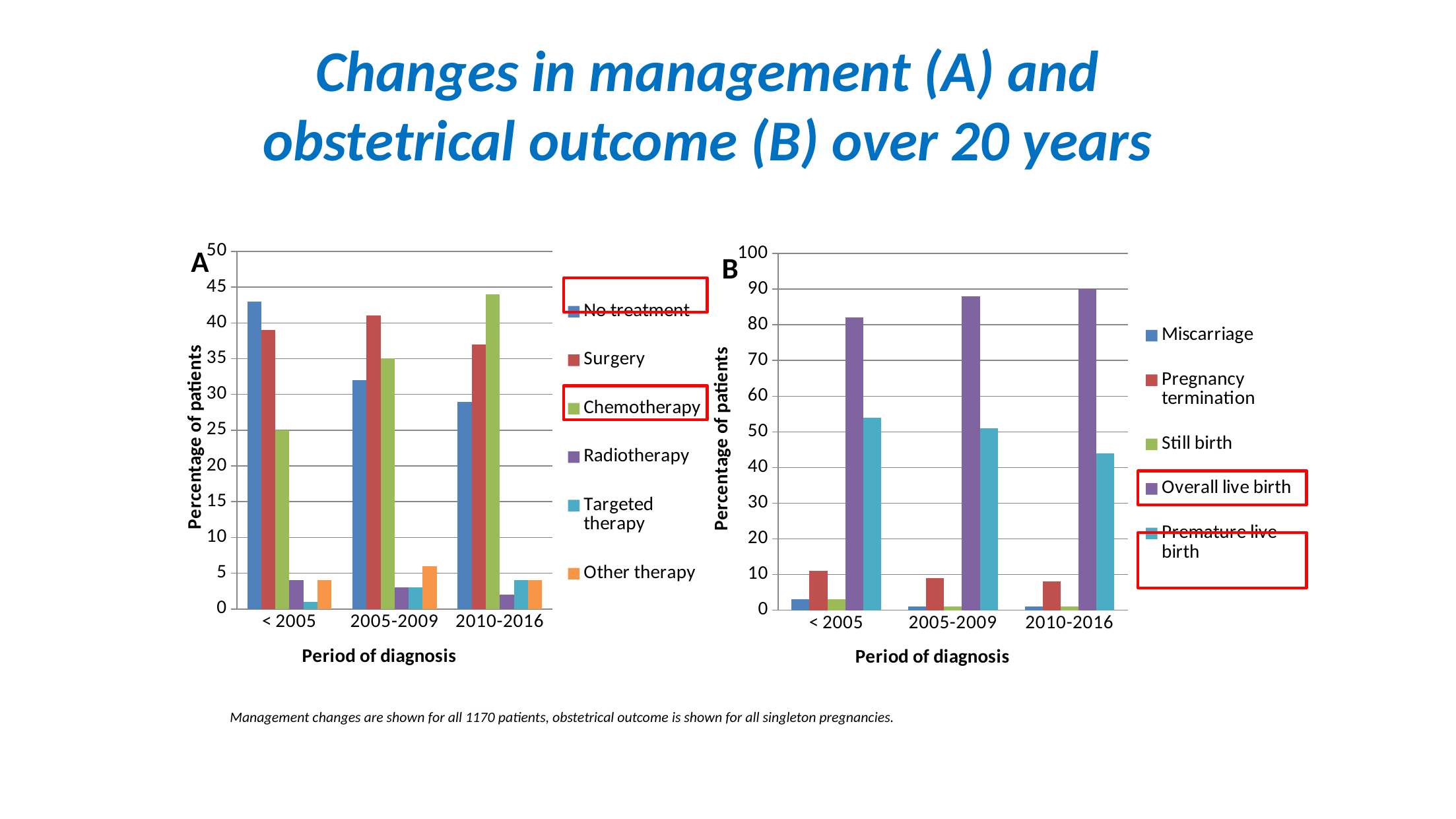
What kind of chart is chart A? bar chart In chart B, does the percentage for Overall live birth rise or fall from < 2005 to 2010-2016? rise In chart A, does the percentage for No treatment rise or fall from < 2005 to 2010-2016? fall In chart A, how many series does the legend list? 6 In chart A, is the value for No treatment in < 2005 greater or less than 40? greater In chart B, is the value for Overall live birth in 2010-2016 greater or less than 80? greater In chart A, does the percentage for Chemotherapy rise or fall from < 2005 to 2010-2016? rise In chart B, how many periods of diagnosis are shown on the x axis? 3 In chart B, which is larger in the < 2005 period: Pregnancy termination or Miscarriage? Pregnancy termination In chart B, how many series does the legend list? 5 In chart A, which series has the highest value in the 2010-2016 period? Chemotherapy